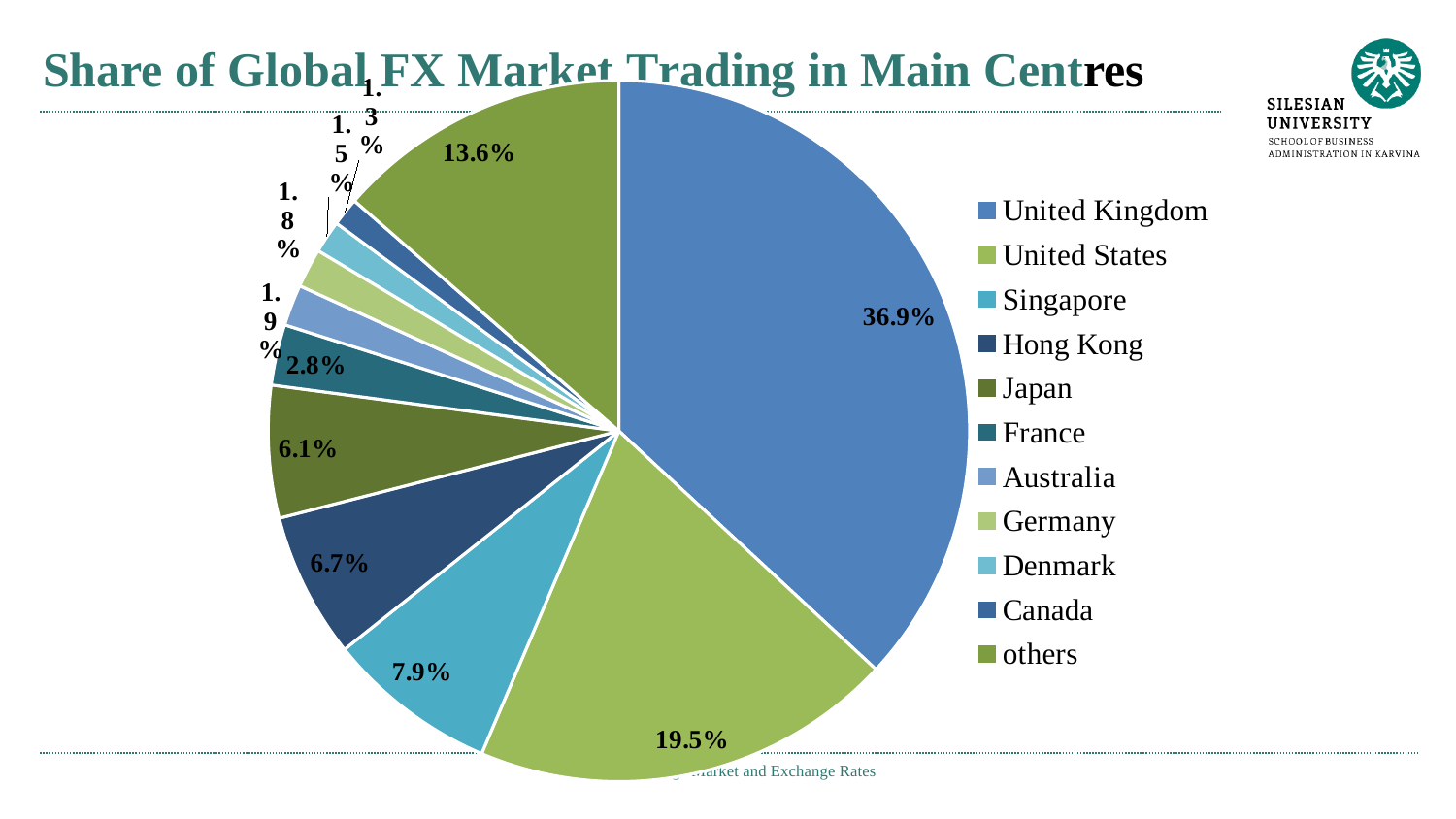
What share is shown for France? 2.8% What share is shown for Hong Kong? 6.7% What share of global FX market trading does the United Kingdom have? 36.9% What share is shown for Japan? 6.1% Which has a larger share, Singapore or Hong Kong? Singapore What kind of chart is shown on the slide? pie chart What share is shown for Singapore? 7.9% What share is shown for the United States? 19.5% What share is shown for the 'others' slice? 13.6% By how many percentage points does the United Kingdom's share exceed the United States' share? 17.4 percentage points Which centre has the largest share of global FX market trading? United Kingdom How many categories are listed in the legend of the pie chart? 11